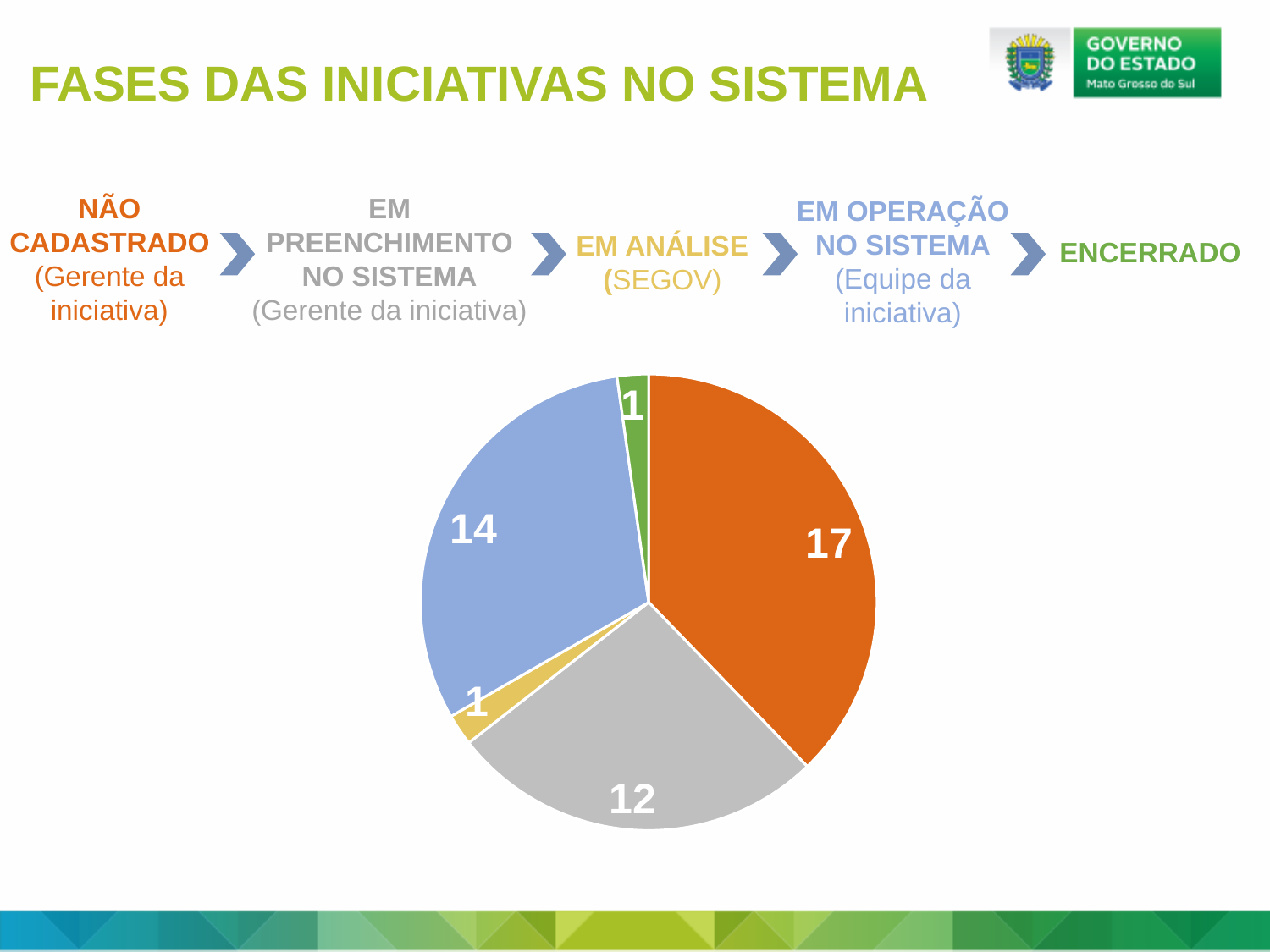
What kind of chart is shown on the slide? pie chart Which phase has the largest slice in the pie chart? NÃO CADASTRADO (orange, 17) What is the total of all the slice values in the pie chart? 45 What is the value of the grey slice (EM PREENCHIMENTO NO SISTEMA) in the pie chart? 12 What is the difference between the blue slice (14) and the grey slice (12)? 2 Which is larger in the pie chart, the blue slice (EM OPERAÇÃO NO SISTEMA) or the grey slice (EM PREENCHIMENTO NO SISTEMA)? the blue slice (14) What is the value of the blue slice (EM OPERAÇÃO NO SISTEMA) in the pie chart? 14 How many slices does the pie chart have? 5 What is the value of the green slice (ENCERRADO) in the pie chart? 1 What is the title of the slide containing the pie chart? FASES DAS INICIATIVAS NO SISTEMA What is the value of the orange slice (NÃO CADASTRADO) in the pie chart? 17 What is the difference between the orange slice (17) and the grey slice (12)? 5